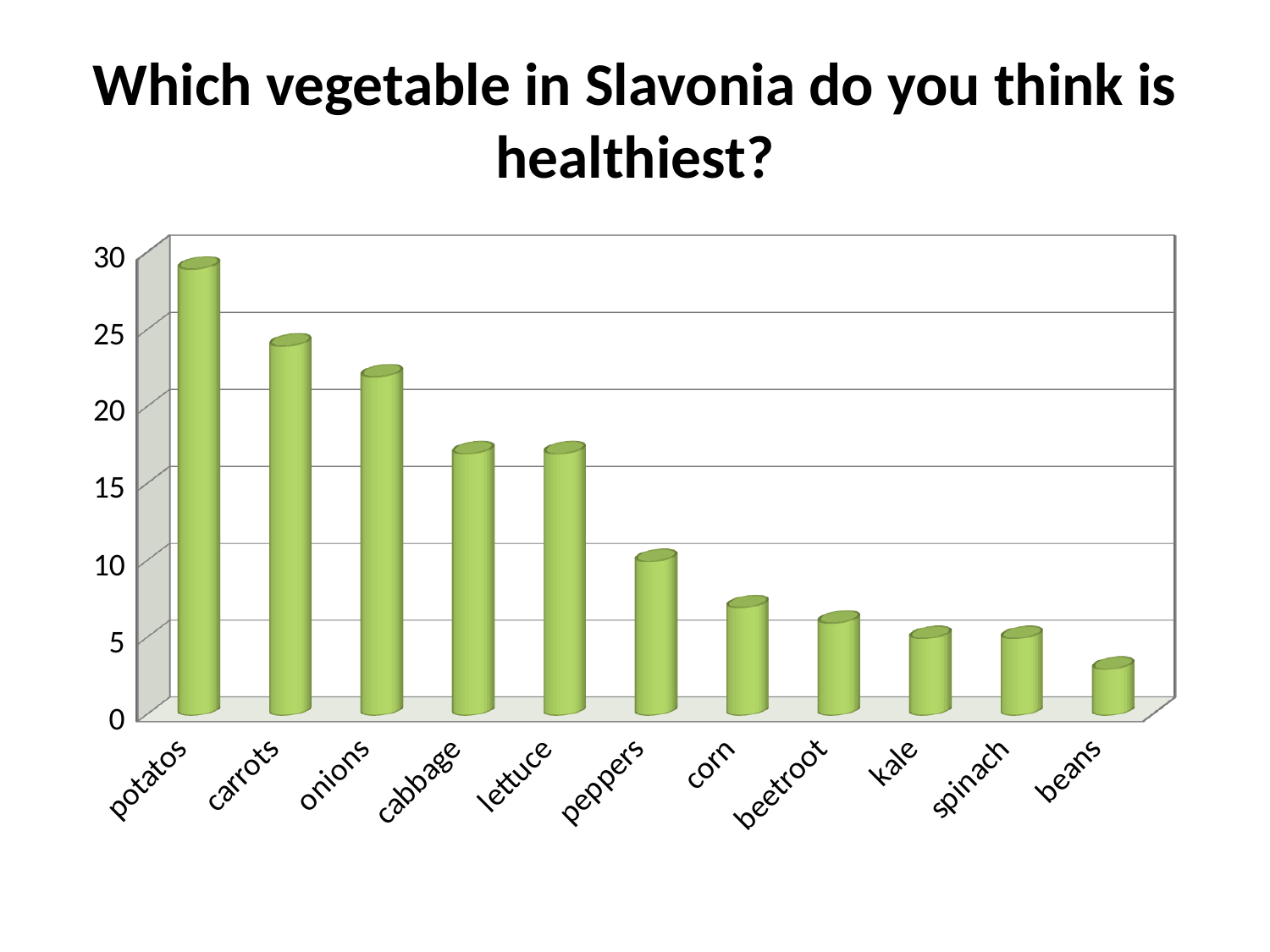
Which has a larger value, peppers or corn? peppers Do the values rise or fall moving from left to right along the x axis? fall How many vegetables are shown on the x axis? 11 What kind of chart is shown on the slide? bar chart Is the value for cabbage greater or less than 20? less Is the value for carrots greater or less than 20? greater Which vegetable has the lowest value? beans Is the value for potatos greater or less than 25? greater Which vegetable has the highest value? potatos What is the title of the chart? Which vegetable in Slavonia do you think is healthiest?